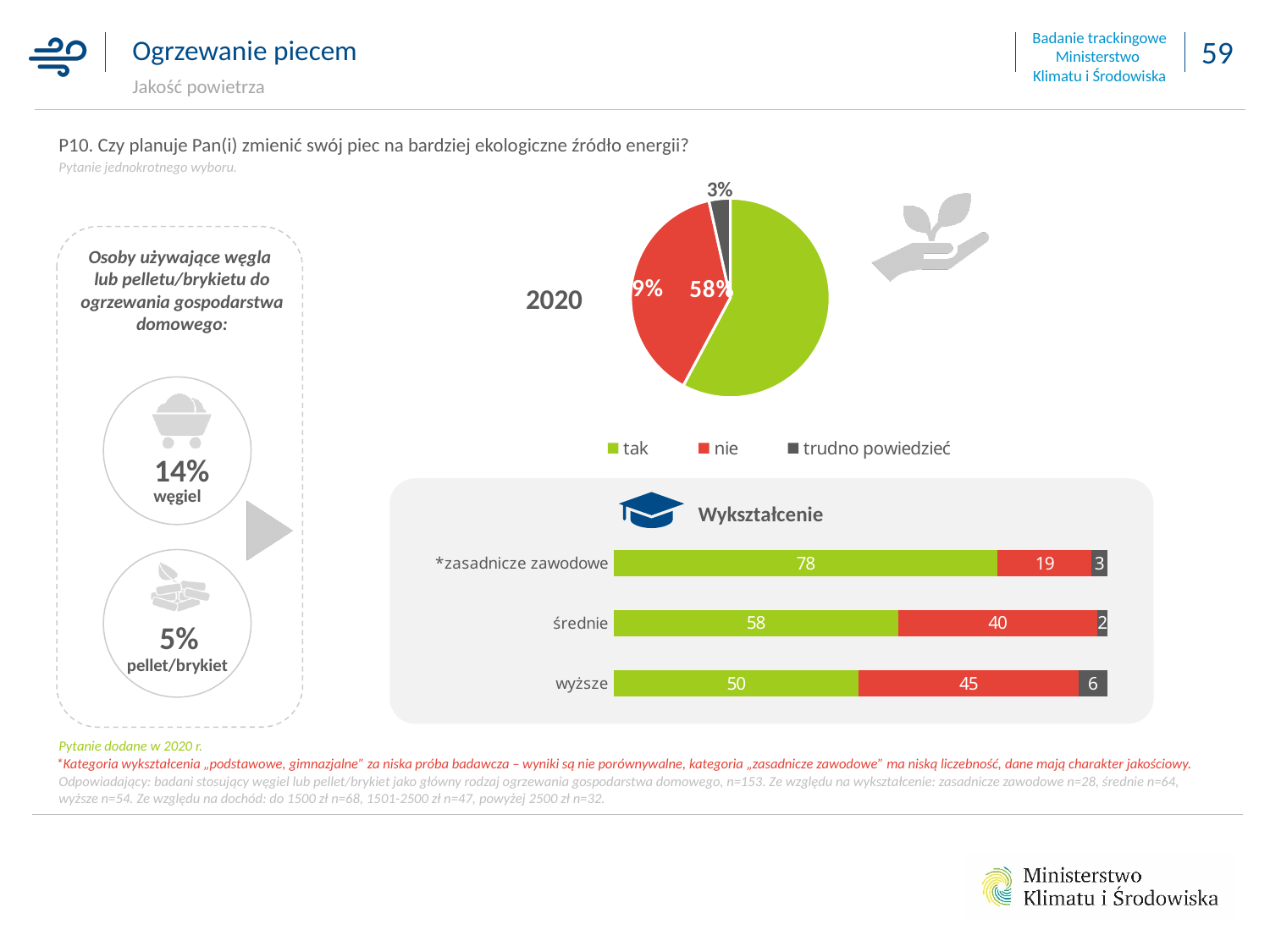
In the 2020 pie chart, what percentage of respondents answered "tak"? 58% How many series does the legend list for the charts on the slide? 3 How many education categories are shown in the Wykształcenie chart? 3 In the Wykształcenie chart, what is the value for "trudno powiedzieć" in the wyższe category? 6 What type of chart is the 2020 chart at the top of the slide? pie chart In the Wykształcenie chart, is the "nie" value larger for wyższe or for średnie? wyższe In the Wykształcenie chart, what is the value for "nie" in the średnie category? 40 In the Wykształcenie chart, which education category has the highest value for "tak"? *zasadnicze zawodowe In the Wykształcenie chart, what is the value for "tak" in the *zasadnicze zawodowe category? 78 In the 2020 pie chart, what percentage of respondents answered "trudno powiedzieć"? 3% In the 2020 pie chart, which answer has the largest slice? tak In the Wykształcenie chart, what is the difference between the "tak" values for *zasadnicze zawodowe and wyższe? 28